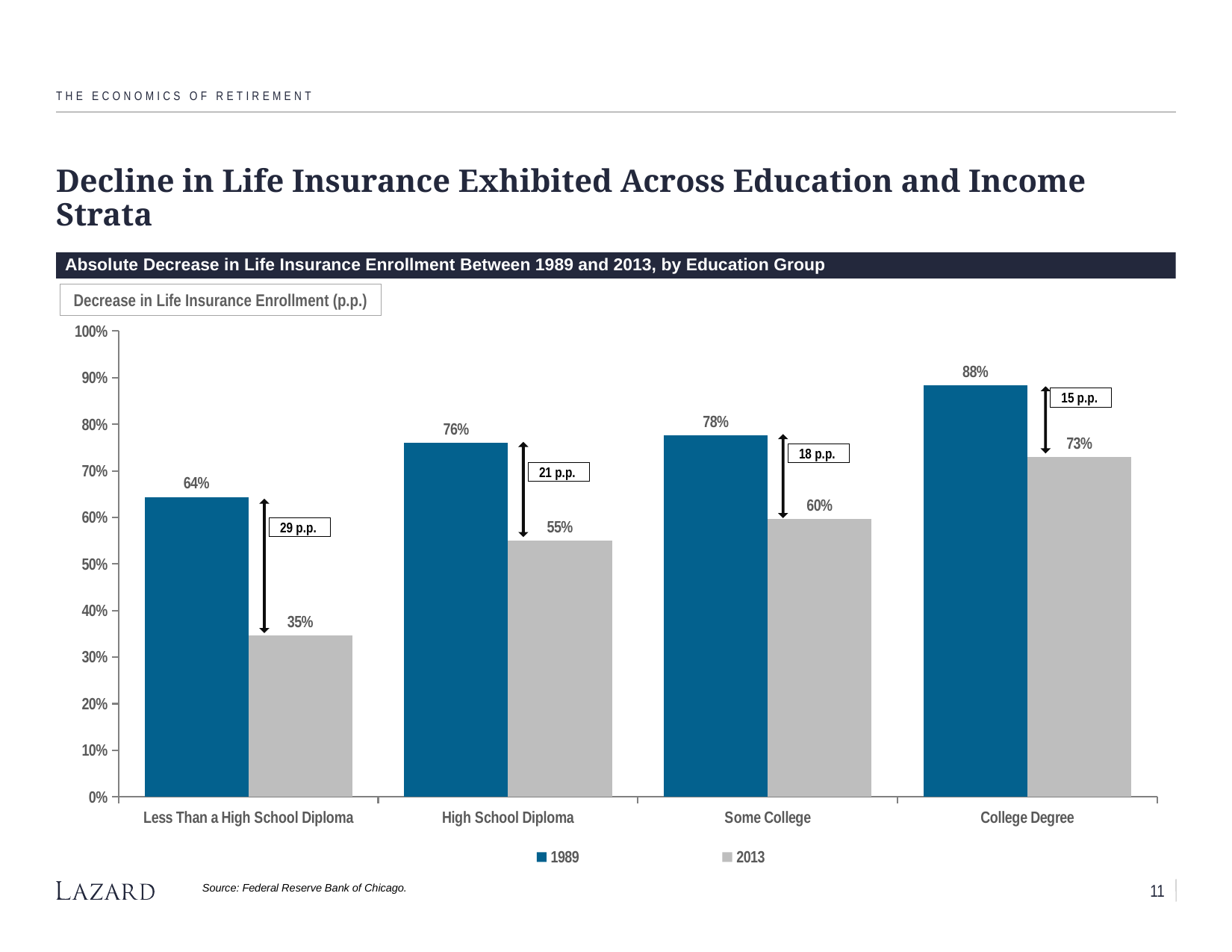
What was the life insurance enrollment rate in 1989 for the Less Than a High School Diploma group? 64% What type of chart is shown on the slide? Bar chart How many series does the legend list? 2 What is the difference between the 1989 and 2013 enrollment rates for the Less Than a High School Diploma group? 29 p.p. Which education group had the lowest enrollment rate in 2013? Less Than a High School Diploma What was the life insurance enrollment rate in 2013 for the College Degree group? 73% Which education group had the highest enrollment rate in 1989? College Degree What is the decrease in percentage points shown for the High School Diploma group? 21 p.p. What was the 2013 enrollment rate for the Some College group? 60% Is the 1989 enrollment rate for Some College greater or less than 70%? greater How many education groups are shown on the x axis? 4 Which is larger: the 2013 enrollment rate for High School Diploma or the 2013 enrollment rate for Some College? Some College